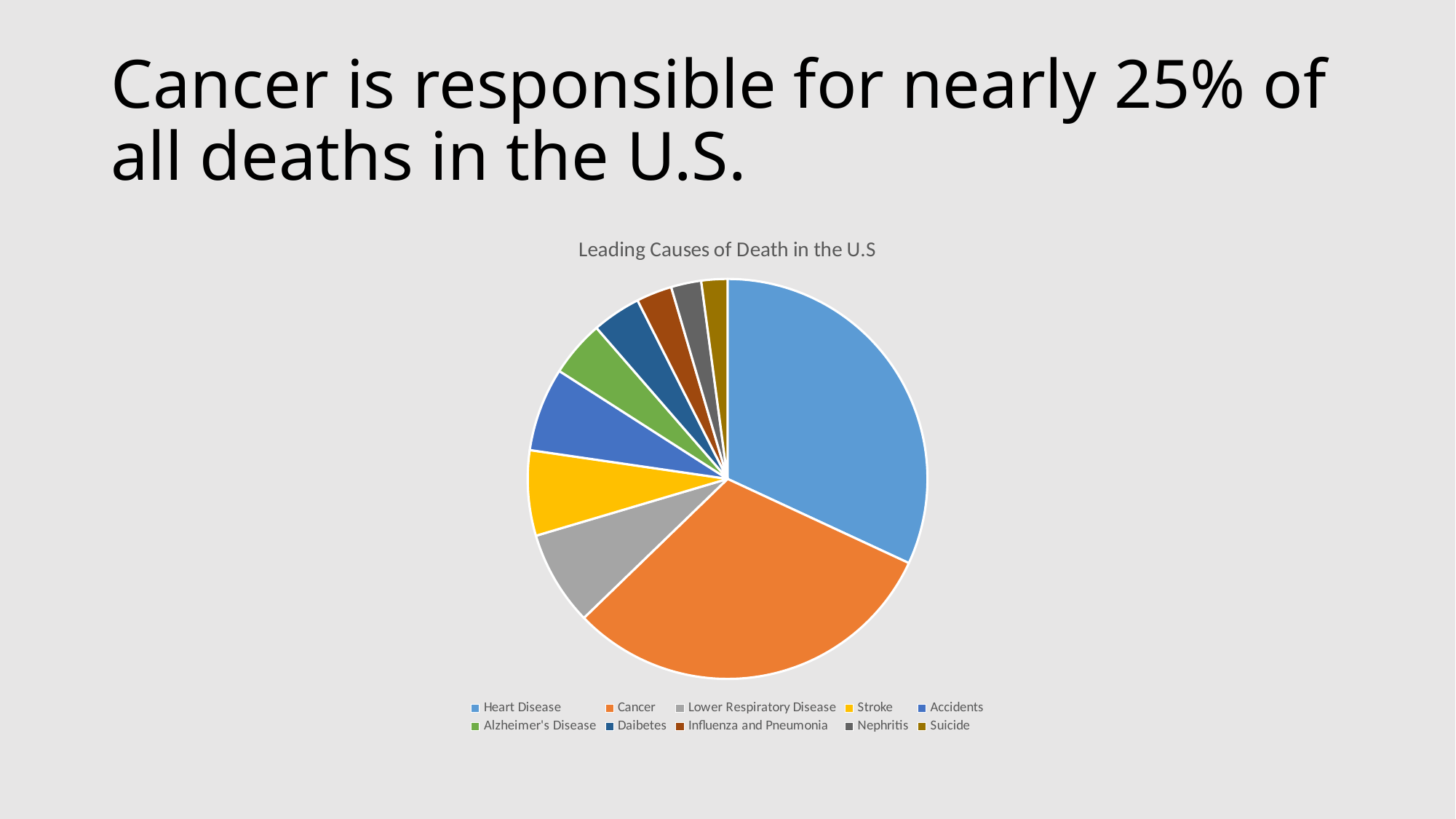
What is the title of the chart? Leading Causes of Death in the U.S Which slice is larger, Cancer or Lower Respiratory Disease? Cancer Which slice is larger, Heart Disease or Stroke? Heart Disease What colour is the Cancer slice in the pie chart? orange Which slice is larger, Stroke or Suicide? Stroke How many categories does the pie chart show? 10 What kind of chart is shown on the slide? pie chart